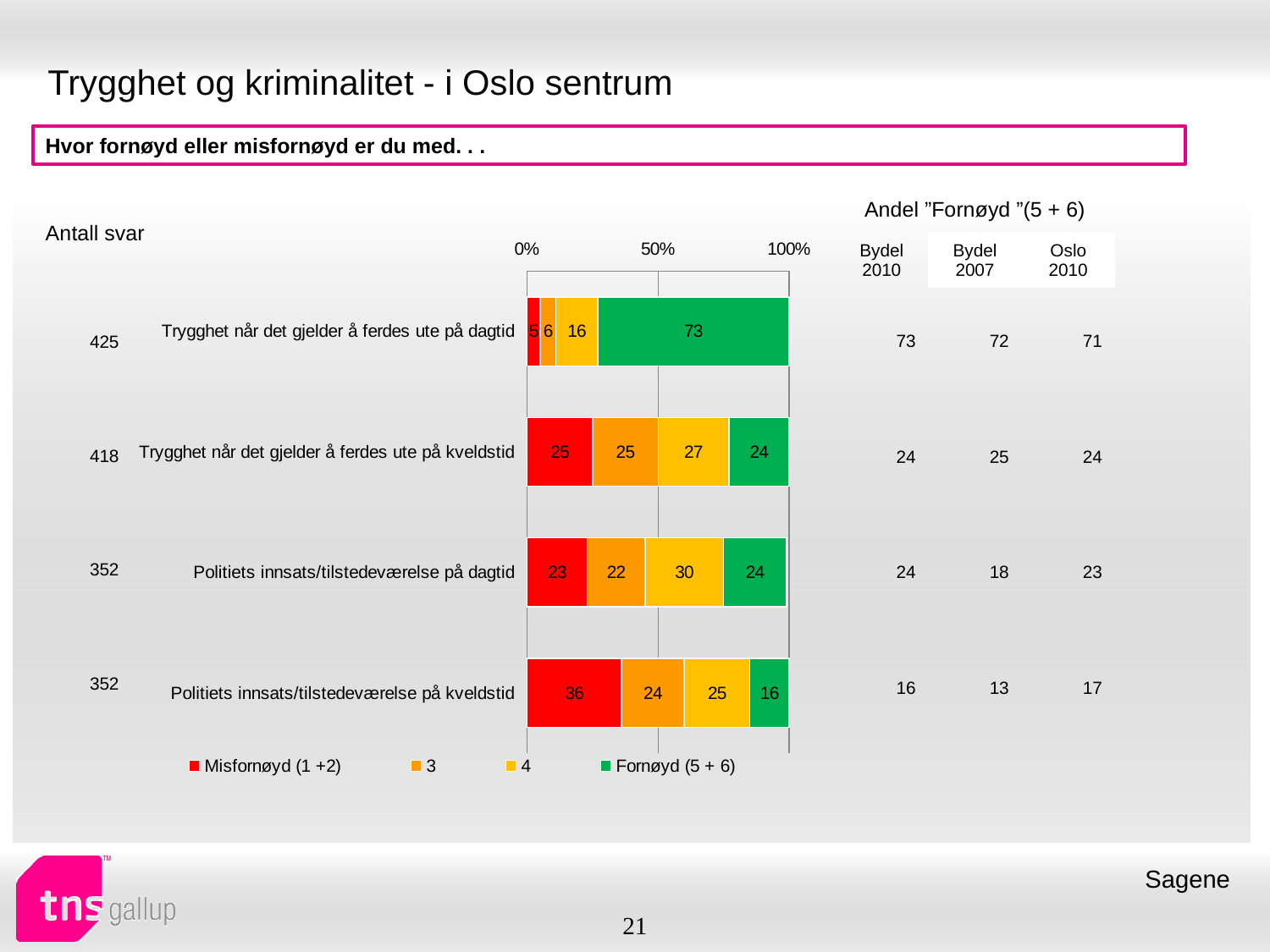
Which category has the lowest "Misfornøyd (1 +2)" value? Trygghet når det gjelder å ferdes ute på dagtid What is the value of series "4" for "Politiets innsats/tilstedeværelse på dagtid"? 30 Which category has the highest "Fornøyd (5 + 6)" value? Trygghet når det gjelder å ferdes ute på dagtid Which is larger: the "Misfornøyd (1 +2)" value for "Politiets innsats/tilstedeværelse på kveldstid" or for "Politiets innsats/tilstedeværelse på dagtid"? Politiets innsats/tilstedeværelse på kveldstid What is the value of series "3" for "Trygghet når det gjelder å ferdes ute på kveldstid"? 25 Which colour represents "Fornøyd (5 + 6)" in the chart? Green What kind of chart is shown on the slide? Stacked bar chart What is the value of "Fornøyd (5 + 6)" for "Trygghet når det gjelder å ferdes ute på dagtid"? 73 How many categories are shown in the chart? 4 What is the difference between the "Fornøyd (5 + 6)" values for "Trygghet når det gjelder å ferdes ute på dagtid" and "Politiets innsats/tilstedeværelse på kveldstid"? 57 How many series does the legend list? 4 What is the value of "Misfornøyd (1 +2)" for "Politiets innsats/tilstedeværelse på kveldstid"? 36